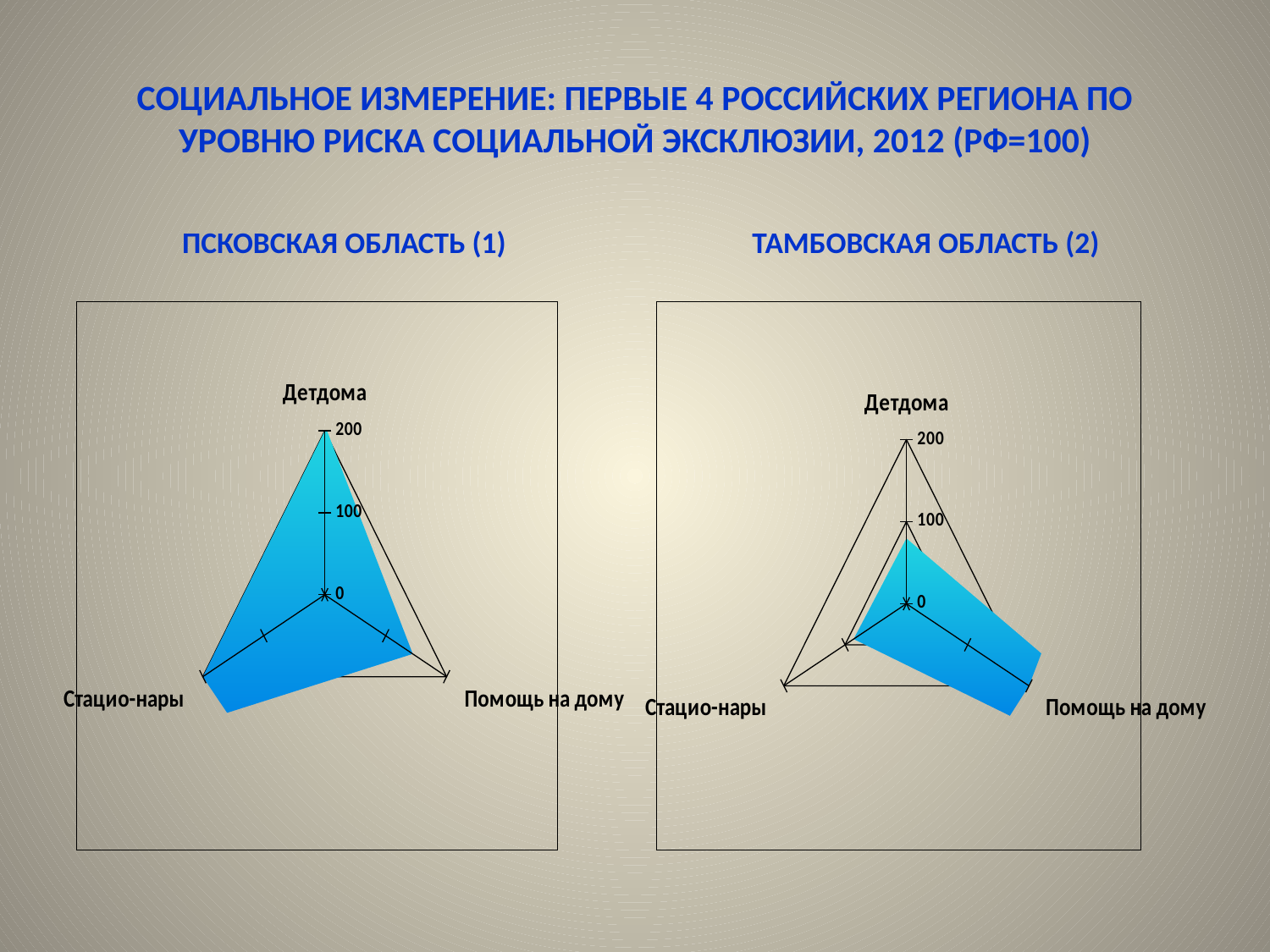
What kind of chart is used for Псковская область (1)? Radar chart In the Тамбовская область (2) chart, is the value for Стацио-нары greater or less than 200? less In the Тамбовская область (2) chart, which category has the highest value? Помощь на дому In the Тамбовская область (2) chart, which is larger: Помощь на дому or Детдома? Помощь на дому In the Псковская область (1) chart, which category has the lowest value? Помощь на дому What is the maximum value shown on the axis scale of the Псковская область (1) chart? 200 In the Псковская область (1) chart, is the value for Детдома greater or less than 100? greater In the Псковская область (1) chart, which is larger: Детдома or Помощь на дому? Детдома In the Псковская область (1) chart, is the value for Помощь на дому greater or less than 100? greater How many categories (axes) does the Тамбовская область (2) chart have? 3